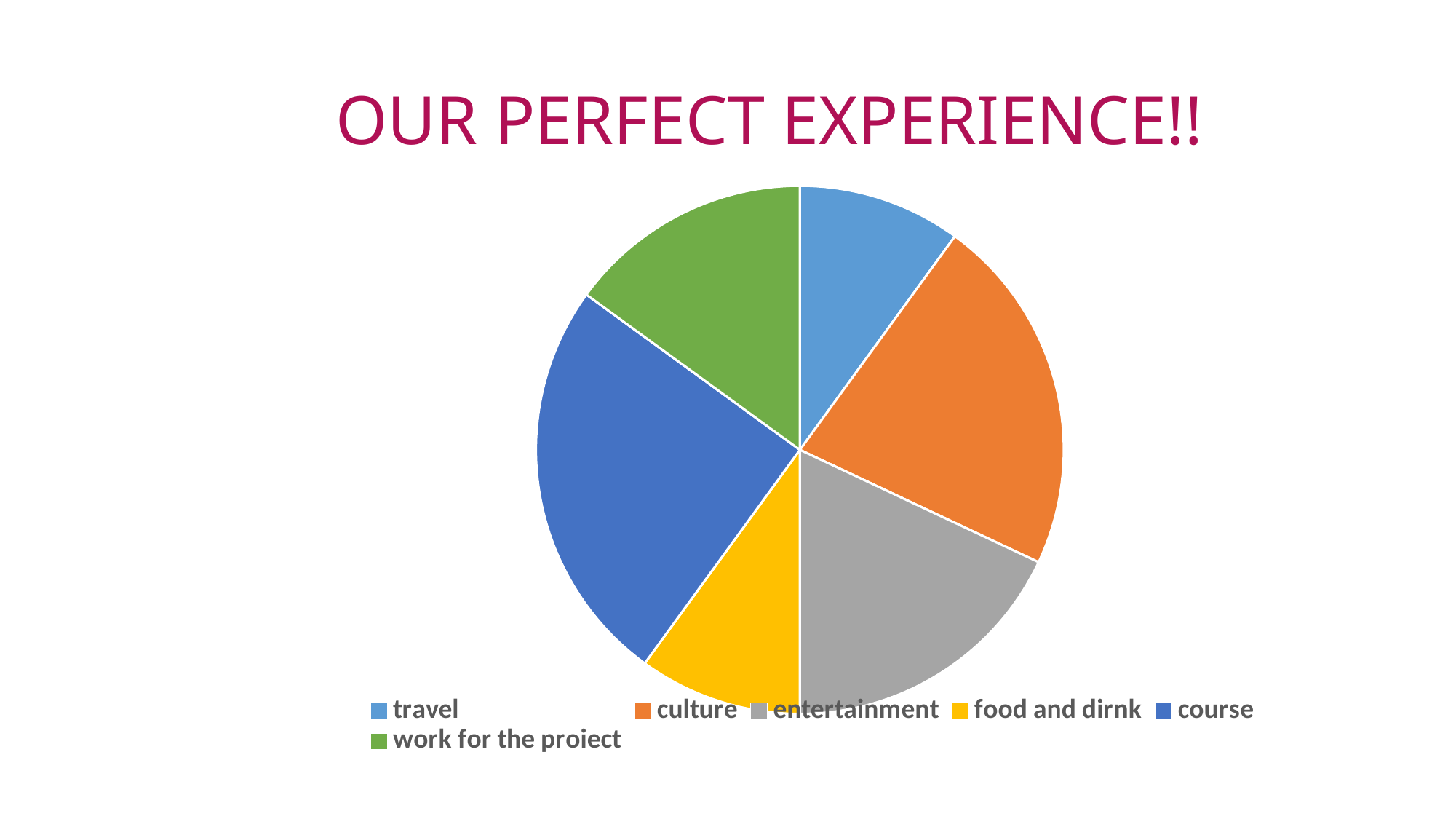
How many slices does the pie chart have? 6 How many entries does the legend of the pie chart list? 6 What is the title shown above the pie chart? OUR PERFECT EXPERIENCE!! Which slice is larger, culture or food and dirnk? culture Which slice is larger, culture or travel? culture Which category is shown in green in the pie chart? work for the proiect Which category has the largest slice of the pie chart? course Which slice is larger, course or work for the proiect? course What kind of chart is shown on the slide? pie chart